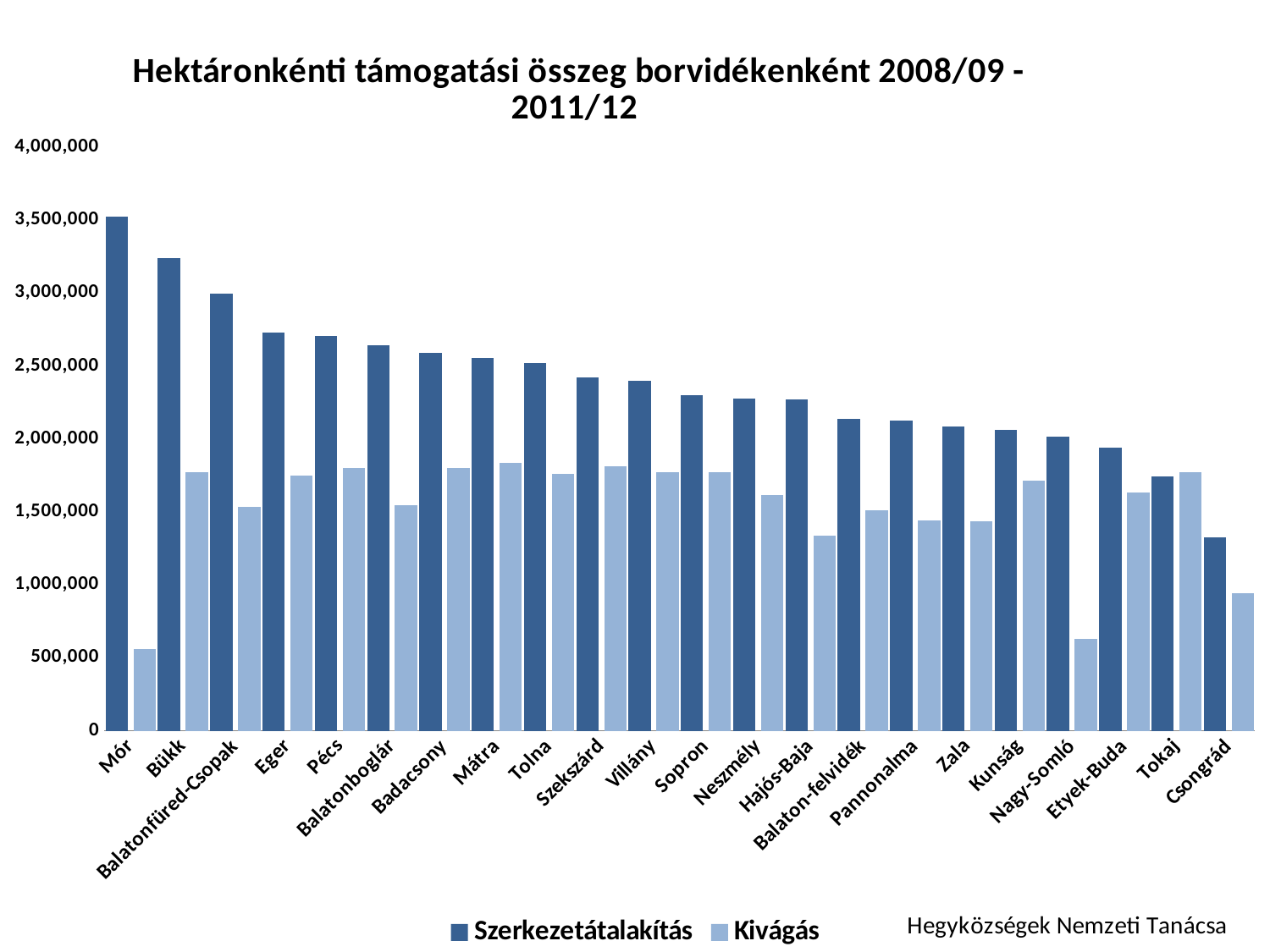
Is the Szerkezetátalakítás value for Eger greater or less than 2,500,000? greater For Csongrád, which is larger: Szerkezetátalakítás or Kivágás? Szerkezetátalakítás What is the title of the chart? Hektáronkénti támogatási összeg borvidékenként 2008/09 - 2011/12 Do the Szerkezetátalakítás values generally rise or fall from left to right along the x axis? fall Is the Kivágás value for Nagy-Somló greater or less than 1,000,000? less Which wine region has the lowest Kivágás value? Mór How many series does the legend list? 2 What kind of chart is shown on the slide? bar chart How many wine regions (categories) are shown on the x axis? 22 Is the Szerkezetátalakítás value for Bükk greater or less than 3,000,000? greater Which wine region has the lowest Szerkezetátalakítás value? Csongrád Which wine region has the highest Szerkezetátalakítás value? Mór